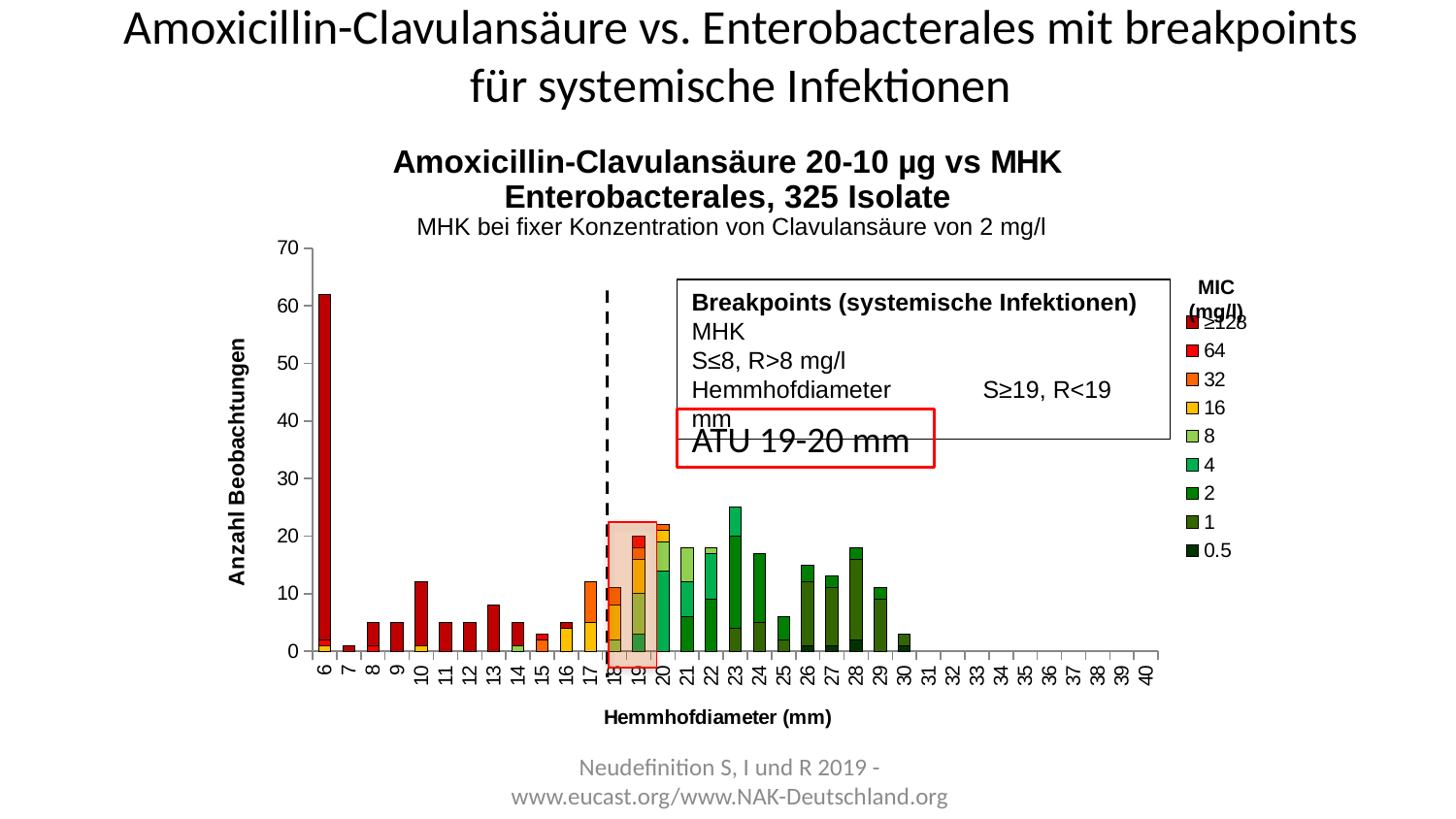
Is the total value for Hemmhofdiameter 6 mm greater or less than 50? greater Is the total value for Hemmhofdiameter 23 mm greater or less than 20? greater Is the total value for Hemmhofdiameter 25 mm greater or less than 10? less What is the label of the y axis? Anzahl Beobachtungen What is the label of the x axis? Hemmhofdiameter (mm) What kind of chart is shown on the slide? Stacked bar chart Which bar is taller: Hemmhofdiameter 6 mm or 23 mm? 6 mm Which Hemmhofdiameter (mm) has the highest total number of observations? 6 Which bar is taller: Hemmhofdiameter 23 mm or 28 mm? 23 mm How many series does the legend (MIC (mg/l)) list? 9 How many Hemmhofdiameter categories are shown on the x axis? 35